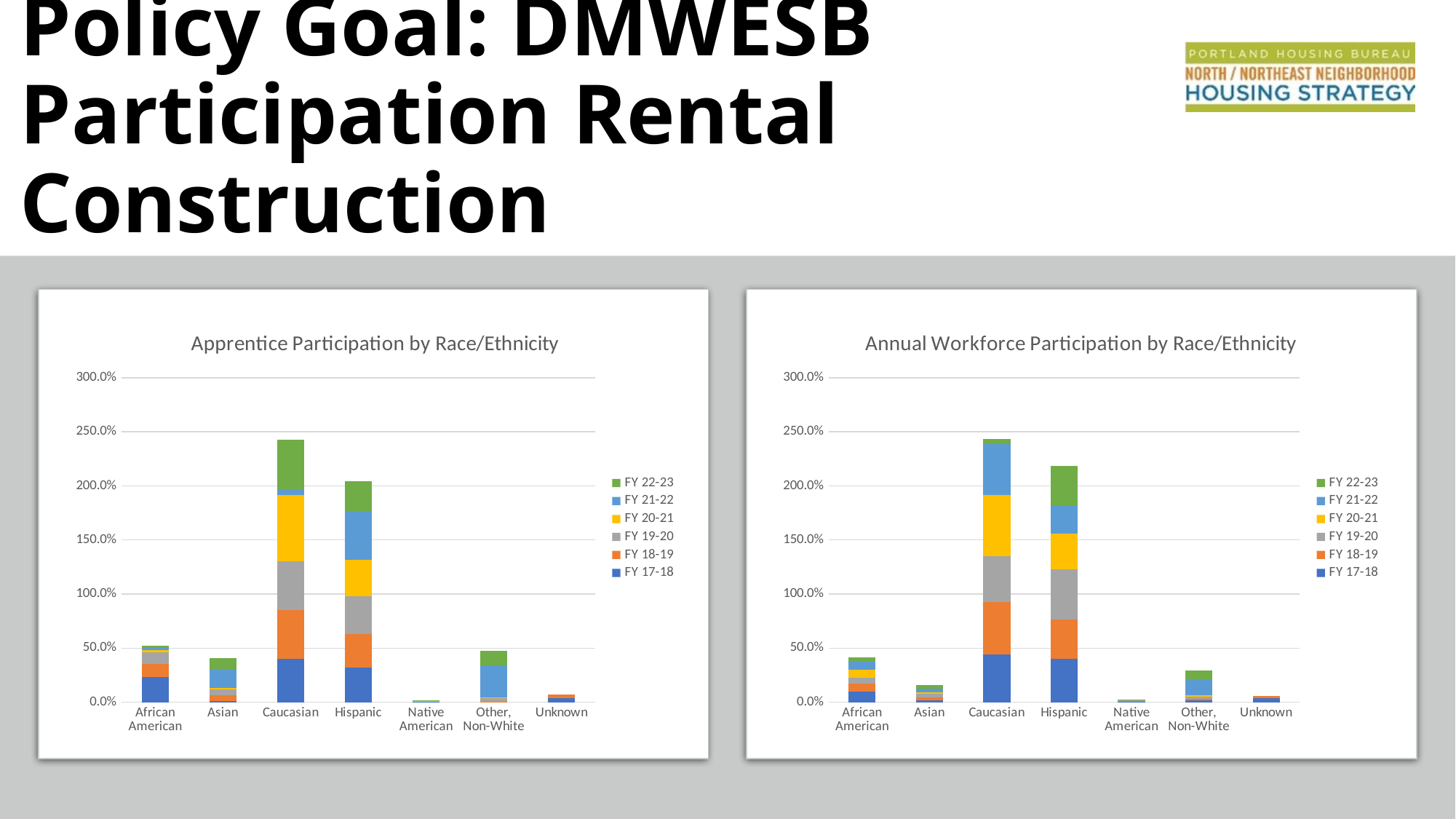
In the 'Apprentice Participation by Race/Ethnicity' chart, which category has the shortest stacked bar? Native American How many race/ethnicity categories are shown on the x axis of the 'Annual Workforce Participation by Race/Ethnicity' chart? 7 In the 'Annual Workforce Participation by Race/Ethnicity' chart, which category has the tallest stacked bar? Caucasian In the 'Apprentice Participation by Race/Ethnicity' chart, is the total stacked value for Caucasian greater or less than 200.0%? greater How many series does the legend of the 'Apprentice Participation by Race/Ethnicity' chart list? 6 In the 'Annual Workforce Participation by Race/Ethnicity' chart, is the total stacked value for Hispanic greater or less than 200.0%? greater In the 'Apprentice Participation by Race/Ethnicity' chart, is the total stacked value for African American greater or less than 100.0%? less Which fiscal year is shown in green in the legend of the 'Annual Workforce Participation by Race/Ethnicity' chart? FY 22-23 In the 'Annual Workforce Participation by Race/Ethnicity' chart, which has the taller stacked bar, African American or Asian? African American What kind of chart is the 'Apprentice Participation by Race/Ethnicity' chart? Stacked bar chart In the 'Apprentice Participation by Race/Ethnicity' chart, which category has the tallest stacked bar? Caucasian